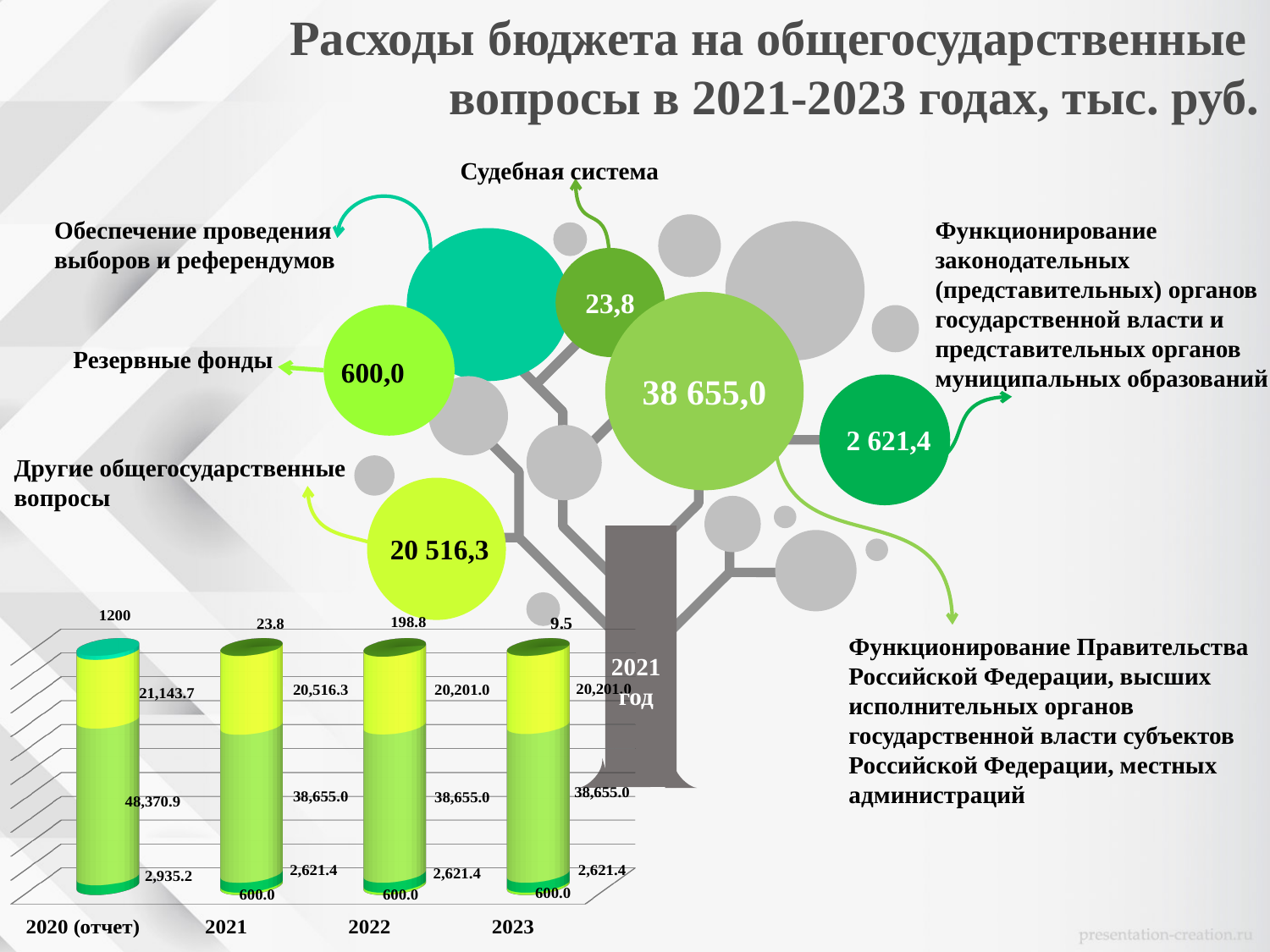
In the bar chart, what is the value of the largest segment of the 2020 (отчет) bar? 48,370.9 In the bar chart, what value is labelled above the top of the 2022 bar? 198.8 In the bar chart, what is the difference between the largest segment of the 2020 (отчет) bar (48,370.9) and the largest segment of the 2021 bar (38,655.0)? 9,715.9 What kind of chart is shown at the bottom left of the slide? Stacked bar chart How many year categories are plotted along the x axis of the bar chart? 4 In the bar chart, what is the value of the bottom segment of the 2020 (отчет) bar? 2,935.2 In the bar chart, what value is labelled above the top of the 2023 bar? 9.5 In the bar chart, does the 38,655.0 segment rise, fall or stay the same from 2021 to 2023? Stays the same In the bar chart, what is the value of the largest segment of the 2021 bar? 38,655.0 In the bar chart, which is larger: the 21,143.7 segment in 2020 (отчет) or the 20,516.3 segment in 2021? 2020 (отчет) In the bar chart, what is the value of the second segment from the top of the 2023 bar? 20,201.0 In the bar chart, which year has the highest value for its largest segment? 2020 (отчет)